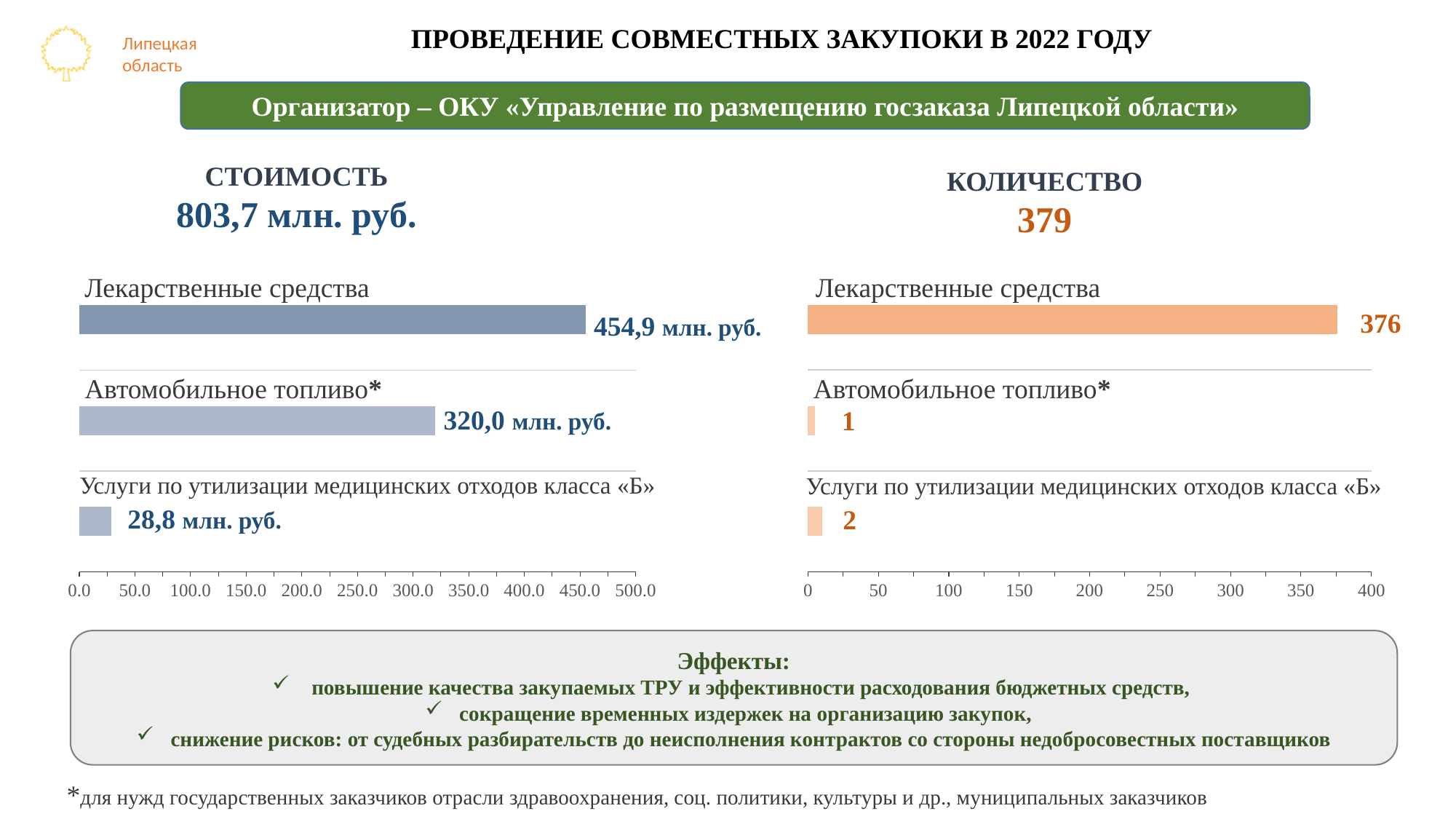
On the СТОИМОСТЬ chart (left), what is the value for Лекарственные средства? 454,9 млн. руб. On the СТОИМОСТЬ chart (left), what is the value for Автомобильное топливо*? 320,0 млн. руб. What kind of chart is the КОЛИЧЕСТВО chart (right)? bar chart How many categories does the СТОИМОСТЬ chart (left) show? 3 On the КОЛИЧЕСТВО chart (right), what is the value for Лекарственные средства? 376 On the СТОИМОСТЬ chart (left), what is the value for Услуги по утилизации медицинских отходов класса «Б»? 28,8 млн. руб. On the КОЛИЧЕСТВО chart (right), what is the value for Автомобильное топливо*? 1 On the КОЛИЧЕСТВО chart (right), what is the difference between Лекарственные средства and Услуги по утилизации медицинских отходов класса «Б»? 374 On the КОЛИЧЕСТВО chart (right), which is larger: Услуги по утилизации медицинских отходов класса «Б» or Автомобильное топливо*? Услуги по утилизации медицинских отходов класса «Б» On the СТОИМОСТЬ chart (left), which category has the highest value? Лекарственные средства On the СТОИМОСТЬ chart (left), what is the difference between Лекарственные средства and Автомобильное топливо*? 134,9 млн. руб. On the КОЛИЧЕСТВО chart (right), which category has the lowest value? Автомобильное топливо*